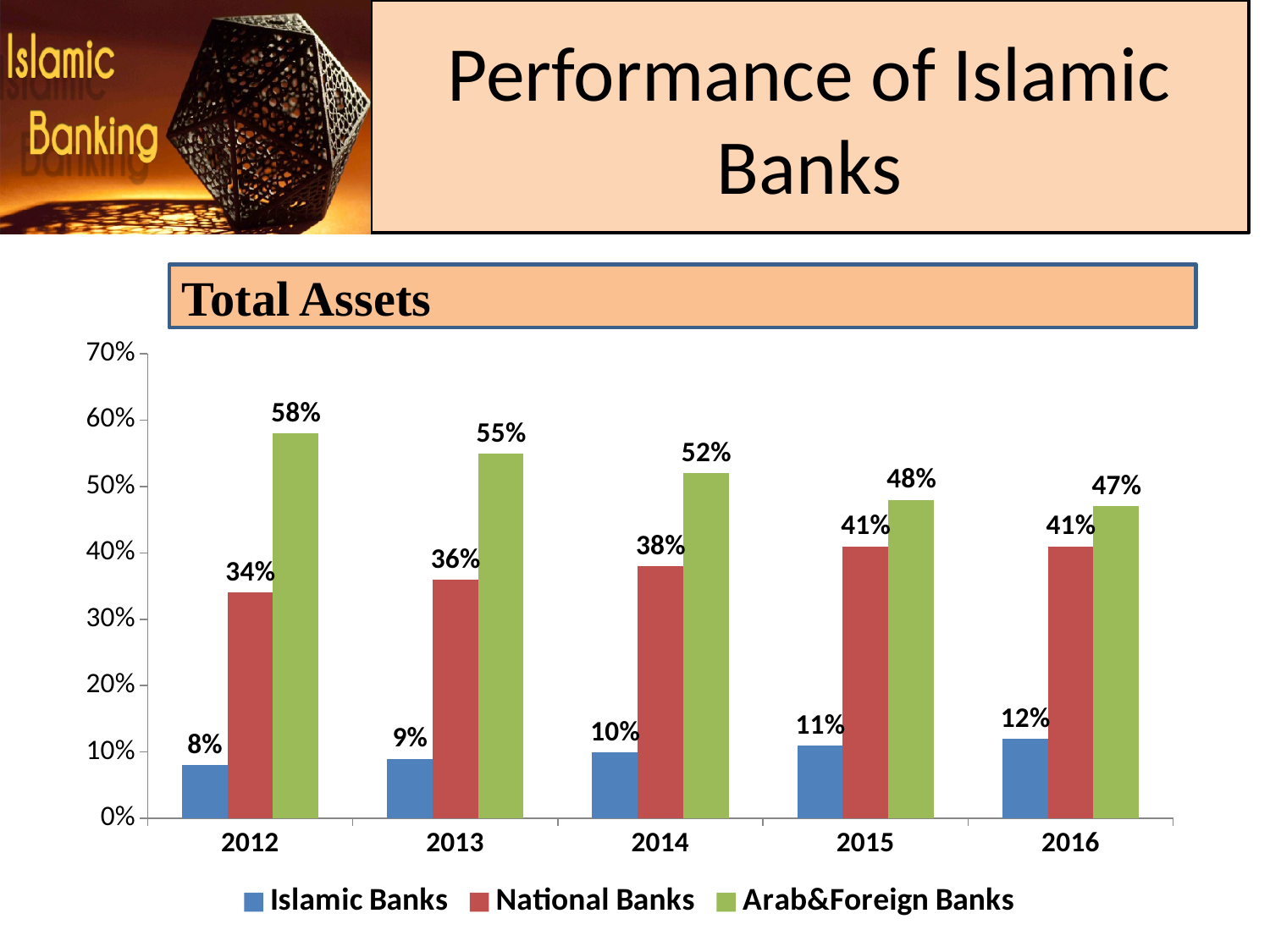
Which is larger in 2015: National Banks or Arab&Foreign Banks? Arab&Foreign Banks What is the value for Islamic Banks in 2014? 10% What is the title of the chart? Total Assets What is the value for Arab&Foreign Banks in 2012? 58% In which year is the Arab&Foreign Banks value highest? 2012 In which year is the Islamic Banks value lowest? 2012 What is the difference between the Arab&Foreign Banks and National Banks values in 2016? 6% Do the Arab&Foreign Banks values rise or fall from 2012 to 2016? Fall How many years are shown on the x axis? 5 What is the value for National Banks in 2013? 36% How many series does the legend list? 3 What kind of chart is shown? Bar chart